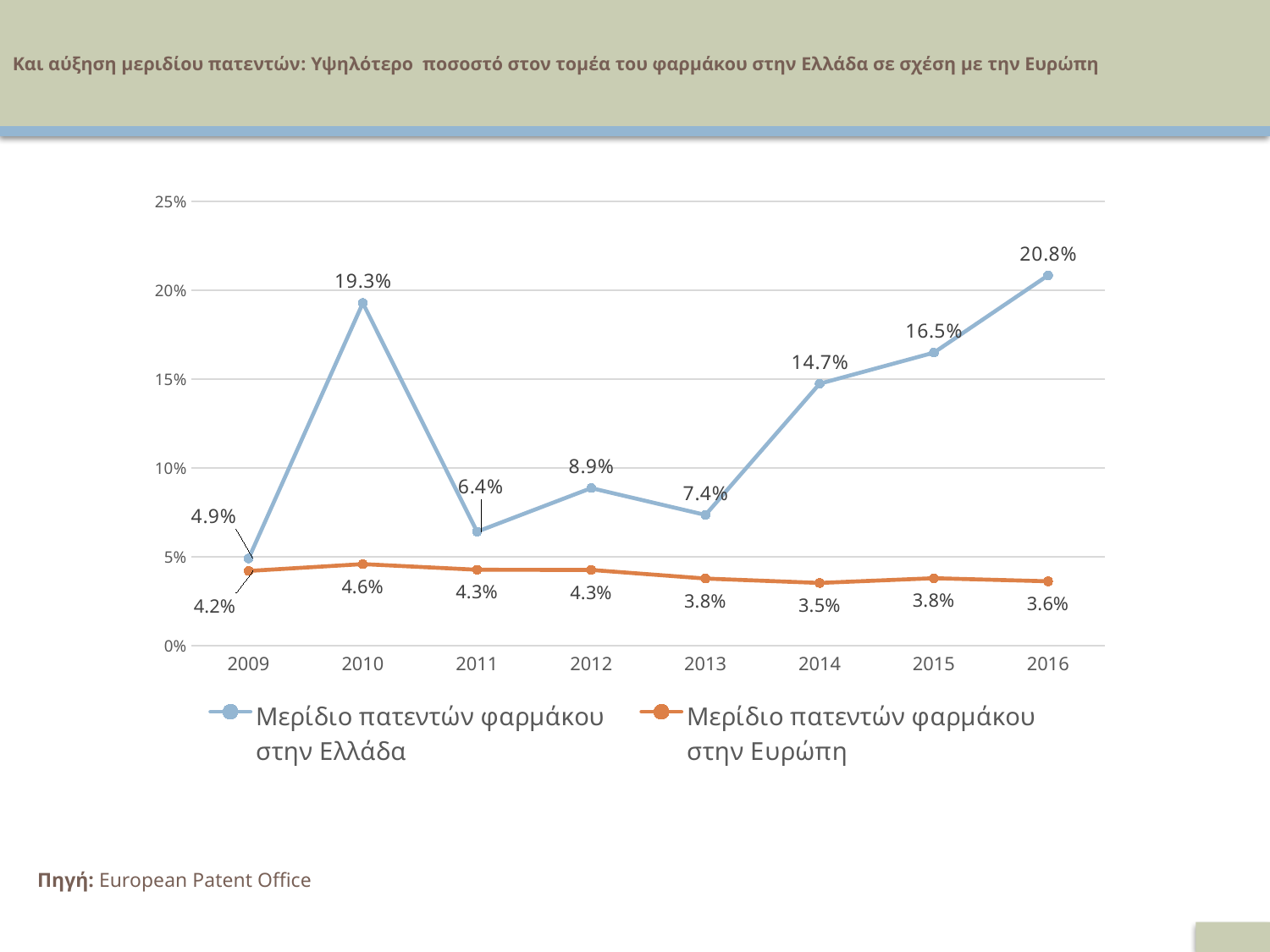
In which year is the share of pharmaceutical patents in Europe (Μερίδιο πατεντών φαρμάκου στην Ευρώπη) highest? 2010 How many series does the legend list? 2 Does the Greece series (Μερίδιο πατεντών φαρμάκου στην Ελλάδα) rise or fall from 2013 to 2016? Rise Which is larger in 2011: the Greece value or the Europe value? Greece (Μερίδιο πατεντών φαρμάκου στην Ελλάδα) In which year is the share of pharmaceutical patents in Greece (Μερίδιο πατεντών φαρμάκου στην Ελλάδα) highest? 2016 What is the difference between the Greece and Europe values in 2016? 17.2% In which year is the share of pharmaceutical patents in Greece (Μερίδιο πατεντών φαρμάκου στην Ελλάδα) lowest? 2009 How many years are shown on the x axis? 8 What is the share of pharmaceutical patents in Greece (Μερίδιο πατεντών φαρμάκου στην Ελλάδα) in 2010? 19.3% What is the value for Greece (Μερίδιο πατεντών φαρμάκου στην Ελλάδα) in 2016? 20.8% What kind of chart is shown on the slide? Line chart What is the share of pharmaceutical patents in Europe (Μερίδιο πατεντών φαρμάκου στην Ευρώπη) in 2014? 3.5%